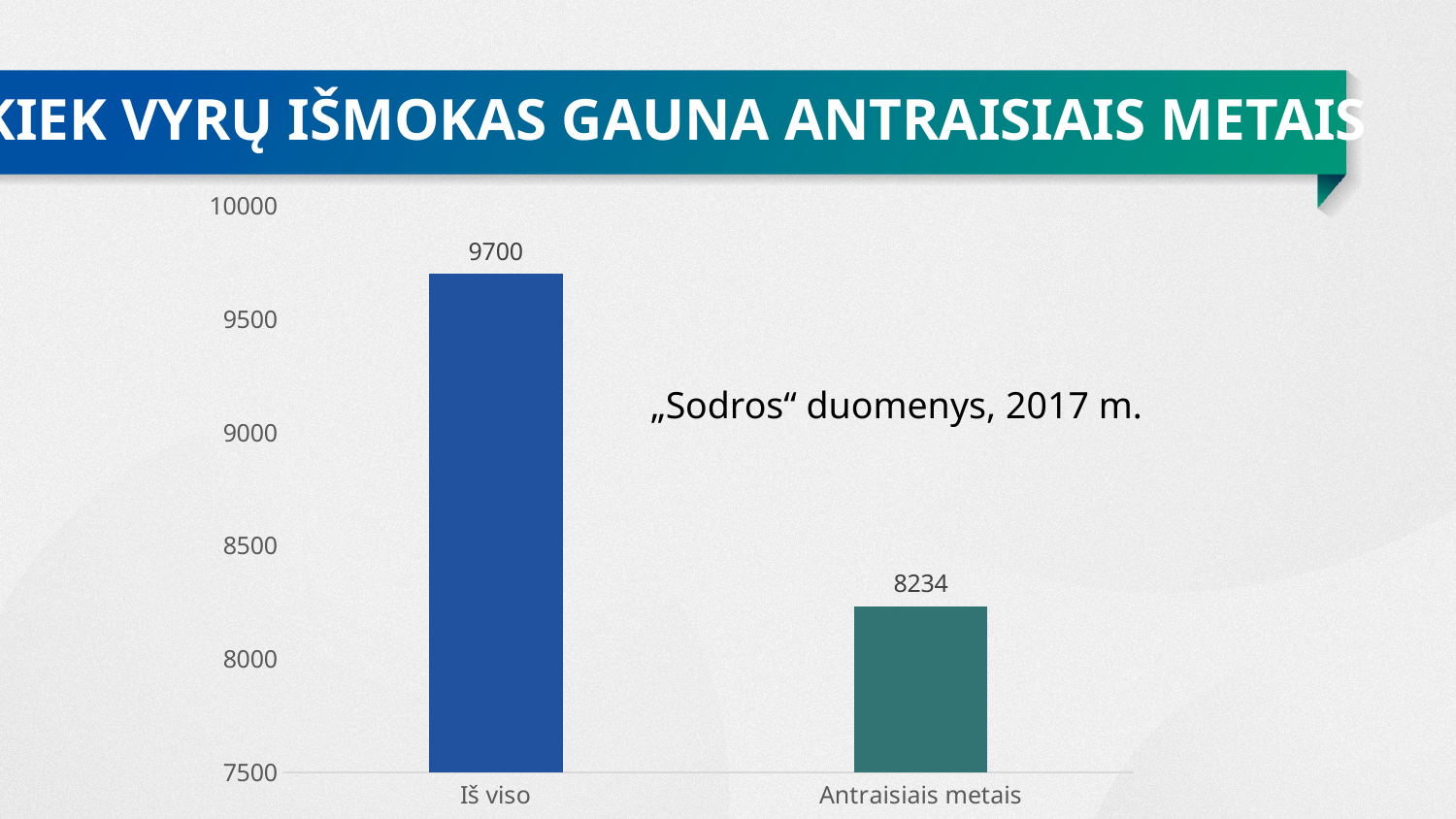
What is the value for "Iš viso"? 9700 What is the value for "Antraisiais metais"? 8234 Is the value for "Antraisiais metais" greater or less than 8500? less Is the value for "Iš viso" greater or less than 9500? greater What data source and year are cited next to the chart? „Sodros“ duomenys, 2017 m. Which is larger, the value for "Iš viso" or for "Antraisiais metais"? Iš viso What kind of chart is shown on the slide? bar chart What is the difference between the values for "Iš viso" and "Antraisiais metais"? 1466 Which category has the highest value? Iš viso What is the title of the slide? KIEK VYRŲ IŠMOKAS GAUNA ANTRAISIAIS METAIS Which category has the lowest value? Antraisiais metais How many categories are shown in the chart? 2